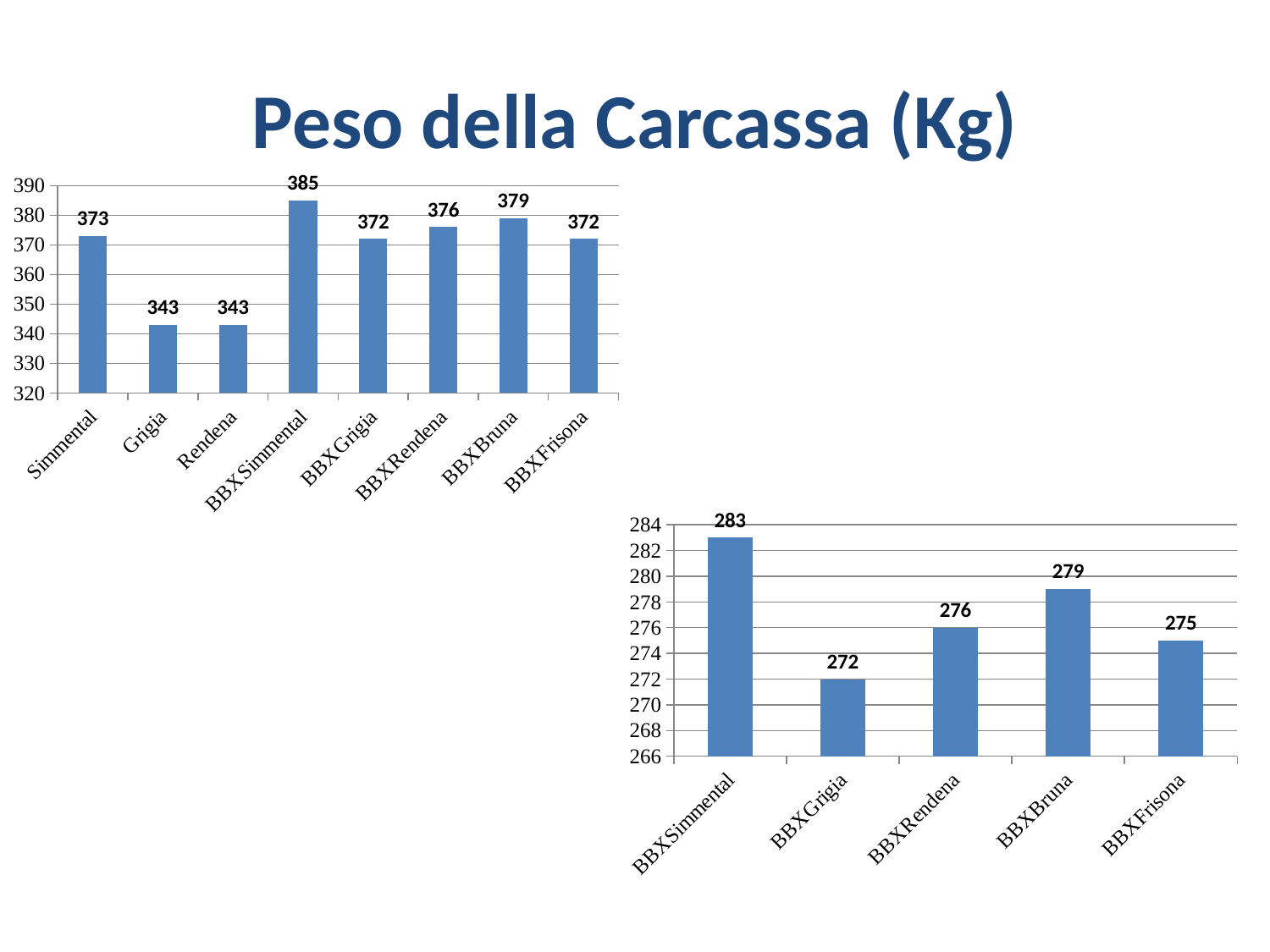
In the bottom-right chart, what is the difference between the values for BBXSimmental and BBXGrigia? 11 In the top-left chart, which is larger, the value for BBXBruna or the value for BBXRendena? BBXBruna In the bottom-right chart, which category has the lowest value? BBXGrigia In the top-left chart, which category has the highest value? BBXSimmental In the top-left chart, what is the value for BBXSimmental? 385 In the bottom-right chart, what is the value for BBXBruna? 279 What kind of chart is the bottom-right chart? Bar chart What is the title of the slide? Peso della Carcassa (Kg) How many categories are shown in the bottom-right chart? 5 In the top-left chart, what is the difference between the values for BBXSimmental and Simmental? 12 In the top-left chart, what is the value for Grigia? 343 How many categories are shown in the top-left chart? 8